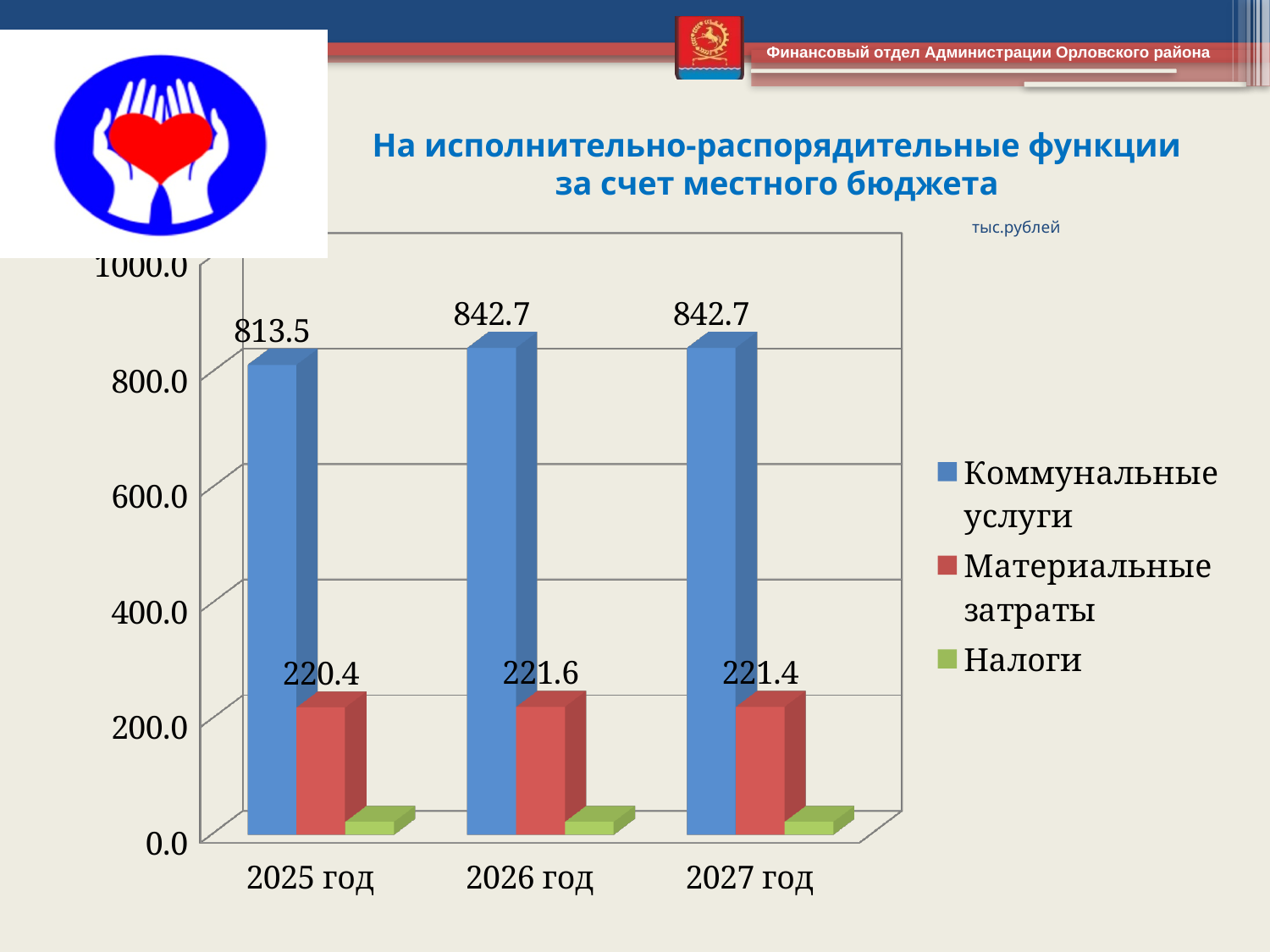
What kind of chart is shown on the slide? bar chart Is the value for Налоги in 2025 год greater or less than 200.0? less What unit is stated for the chart values? тыс.рублей What is the value for Материальные затраты in 2027 год? 221.4 What is the value for Материальные затраты in 2026 год? 221.6 How many series does the legend list? 3 Which is larger in 2025 год: Коммунальные услуги or Материальные затраты? Коммунальные услуги How many years are shown on the x axis? 3 What is the value for Коммунальные услуги in 2025 год? 813.5 What is the difference between the Коммунальные услуги values for 2026 год and 2025 год? 29.2 In which year is the value for Коммунальные услуги lowest? 2025 год What is the value for Коммунальные услуги in 2027 год? 842.7